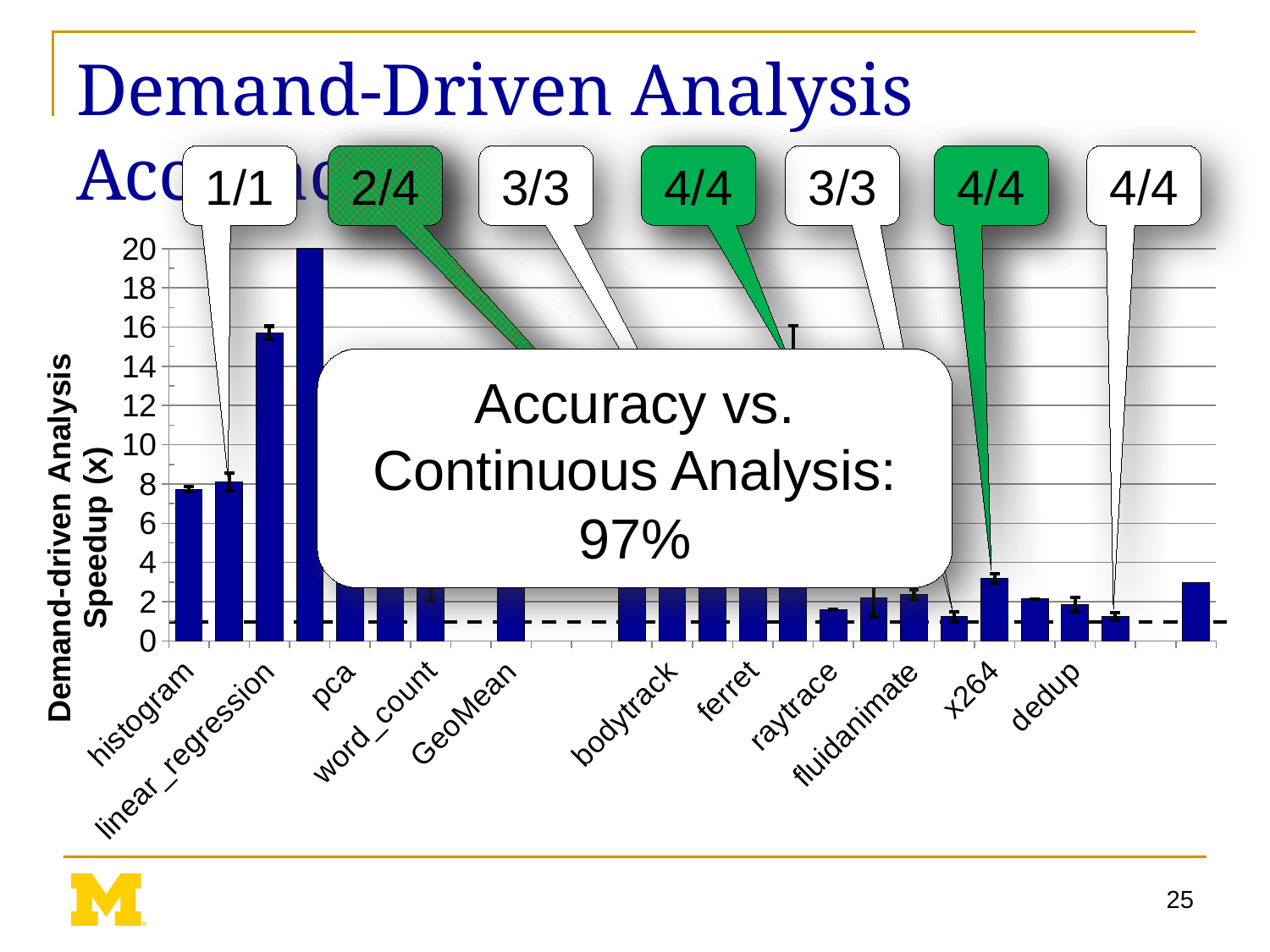
Which has the larger speedup, histogram or dedup? histogram Is the value for histogram greater or less than 4? greater Is the value for dedup greater or less than 4? less Is the value for x264 greater or less than 6? less What kind of chart is shown on the slide? bar chart What accuracy versus continuous analysis is stated in the large callout over the chart? 97% Which has the larger speedup, histogram or x264? histogram What is the label of the vertical axis of the chart? Demand-driven Analysis Speedup (x)